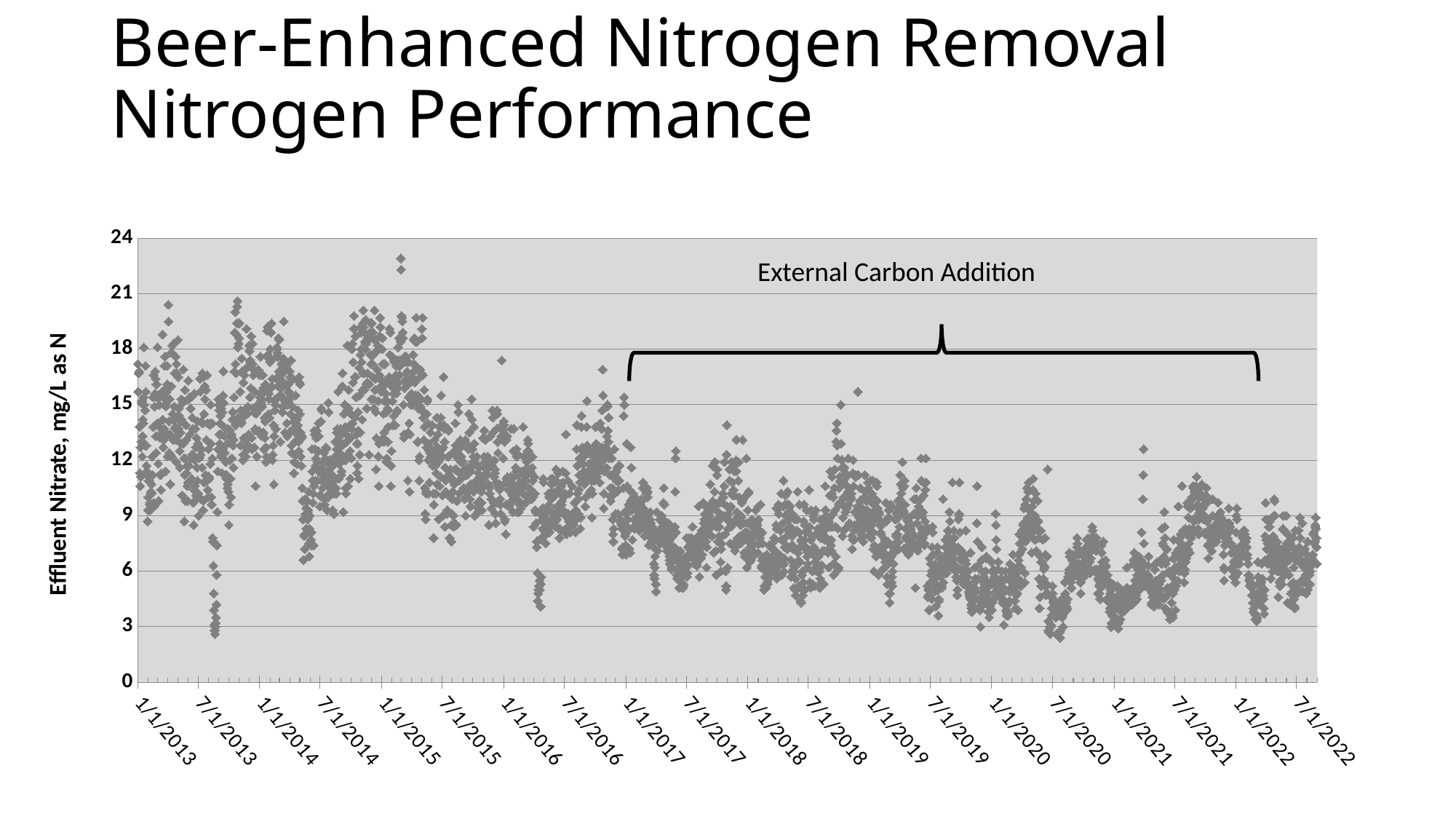
What is the label on the vertical axis of the chart? Effluent Nitrate, mg/L as N Do the effluent nitrate values generally rise or fall from 2013 to 2022? fall Are the effluent nitrate values around 1/1/2014 generally higher or lower than those around 1/1/2020? higher What is the highest value shown on the vertical axis? 24 Is the lowest plotted effluent nitrate value greater or less than 3? less Is the highest plotted effluent nitrate value greater or less than 21? greater What is the interval between consecutive tick marks on the vertical axis? 3 What is the last date label on the horizontal axis? 7/1/2022 What kind of chart is shown on the slide? scatter chart How many date labels are shown on the horizontal axis? 20 What text is written above the bracket in the chart? External Carbon Addition What is the first date label on the horizontal axis? 1/1/2013